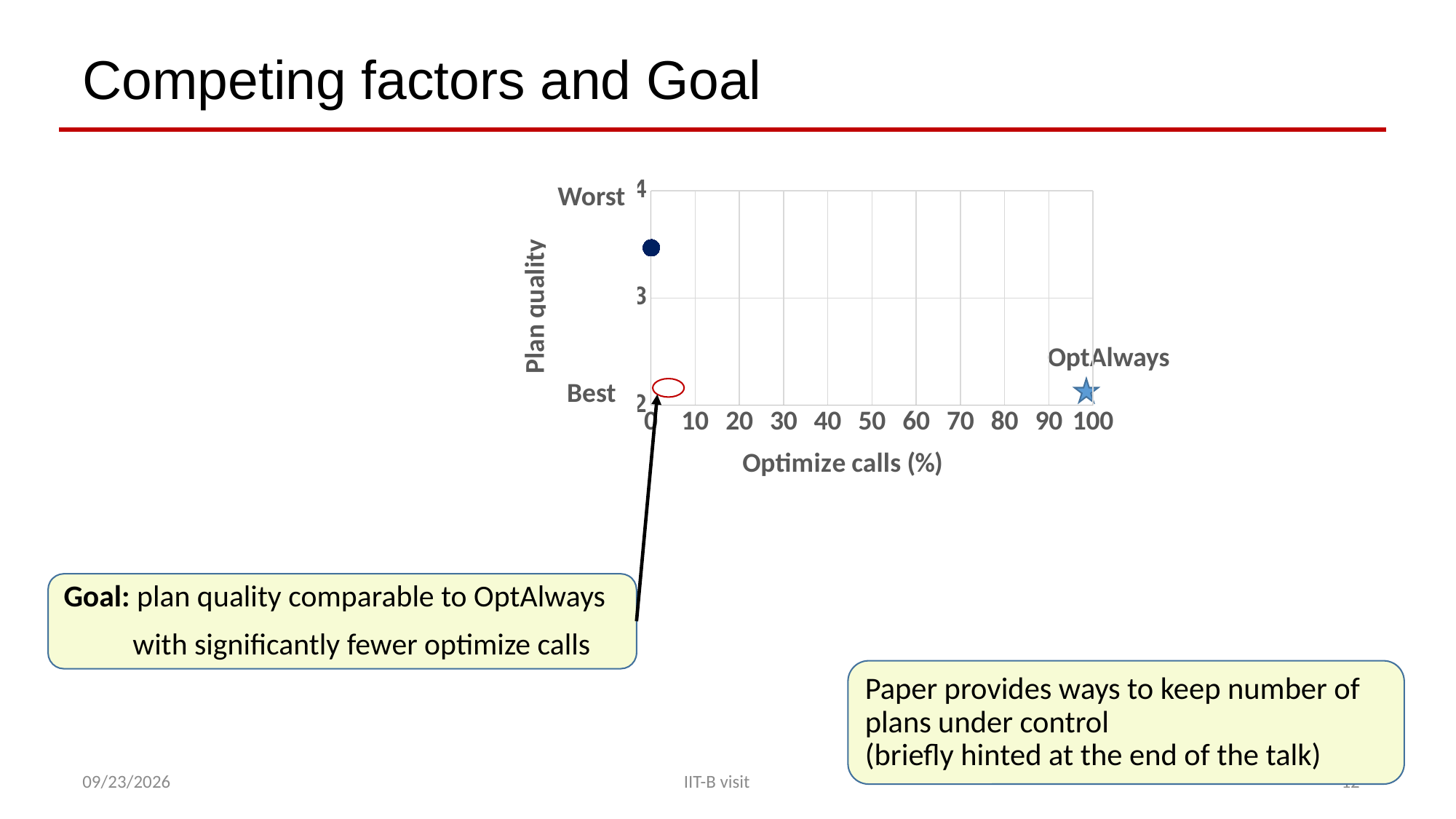
Is the optimize calls (%) value of the dark blue dot greater or less than 10? less What is the plan quality value for the point labelled OptAlways? 2 Which point has the higher optimize calls (%) value, the dark blue dot or the OptAlways star? OptAlways star Is the plan quality value of the dark blue dot greater or less than 3? greater What is the highest value shown on the x axis of the chart? 100 What is the highest value shown on the y axis of the chart? 4 What is the title of the x axis of the chart? Optimize calls (%) What is the title of the y axis of the chart? Plan quality What is the optimize calls (%) value for the point labelled OptAlways? 100 What kind of chart is shown on the slide? scatter chart Which point has the higher plan quality value, the dark blue dot or the OptAlways star? dark blue dot